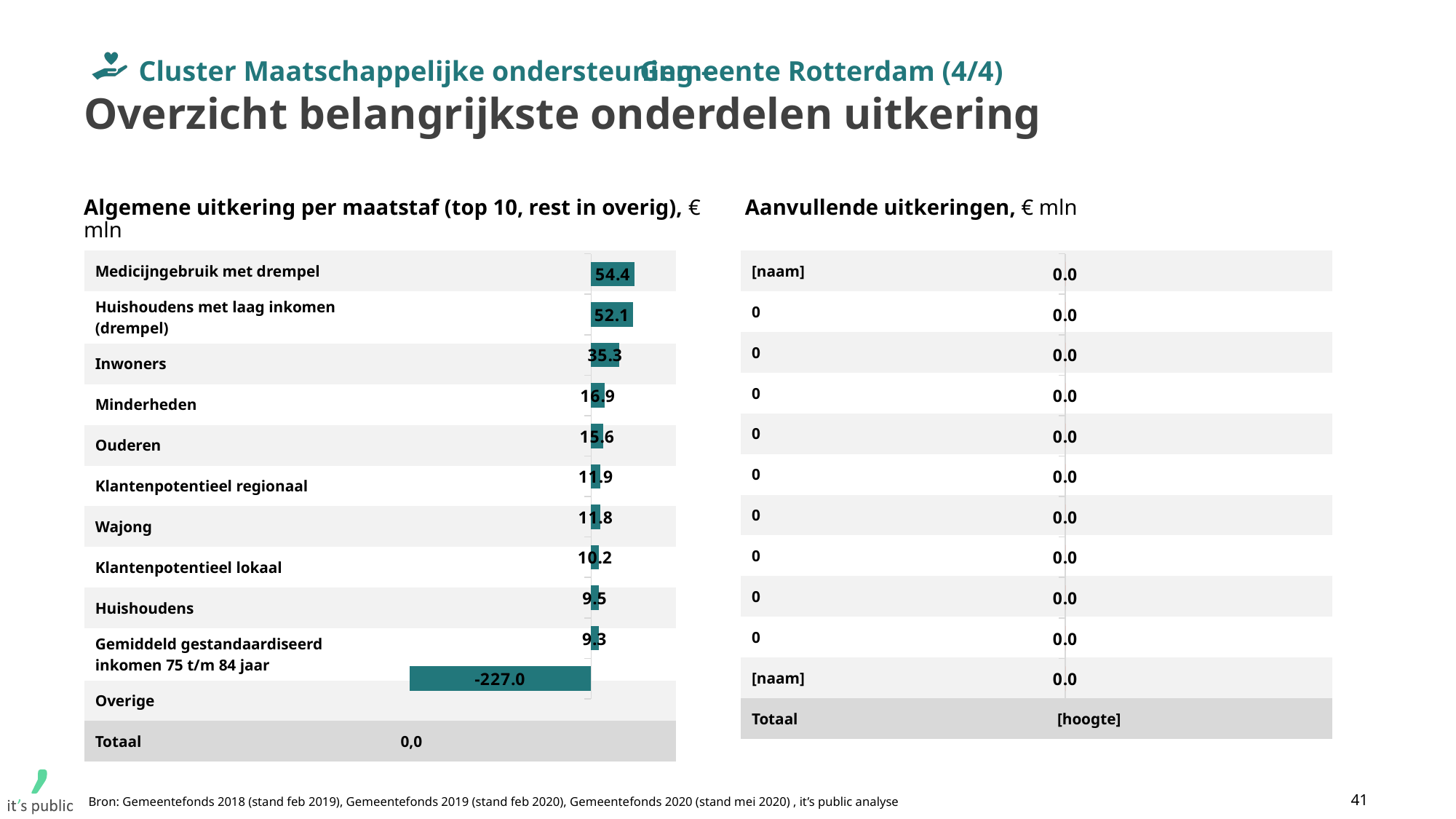
In the chart 'Algemene uitkering per maatstaf', what is the value for Inwoners? 35.3 In the chart 'Algemene uitkering per maatstaf', which category has the lowest value? Overige In the chart 'Algemene uitkering per maatstaf', what is the value for Overige? -227.0 In the chart 'Algemene uitkering per maatstaf', what is the difference between Ouderen and Huishoudens? 6.1 In the chart 'Algemene uitkering per maatstaf', which category has the highest value? Medicijngebruik met drempel What kind of chart is 'Algemene uitkering per maatstaf'? Bar chart What unit is stated in the title of the chart 'Aanvullende uitkeringen'? € mln In the chart 'Algemene uitkering per maatstaf', what is the value for Wajong? 11.8 In the chart 'Algemene uitkering per maatstaf', which is larger: Inwoners or Minderheden? Inwoners In the chart 'Algemene uitkering per maatstaf', what is the value for Medicijngebruik met drempel? 54.4 In the chart 'Algemene uitkering per maatstaf', what is the difference between Medicijngebruik met drempel and Huishoudens met laag inkomen (drempel)? 2.3 How many categories (excluding the Totaal row) are plotted in the chart 'Algemene uitkering per maatstaf'? 11